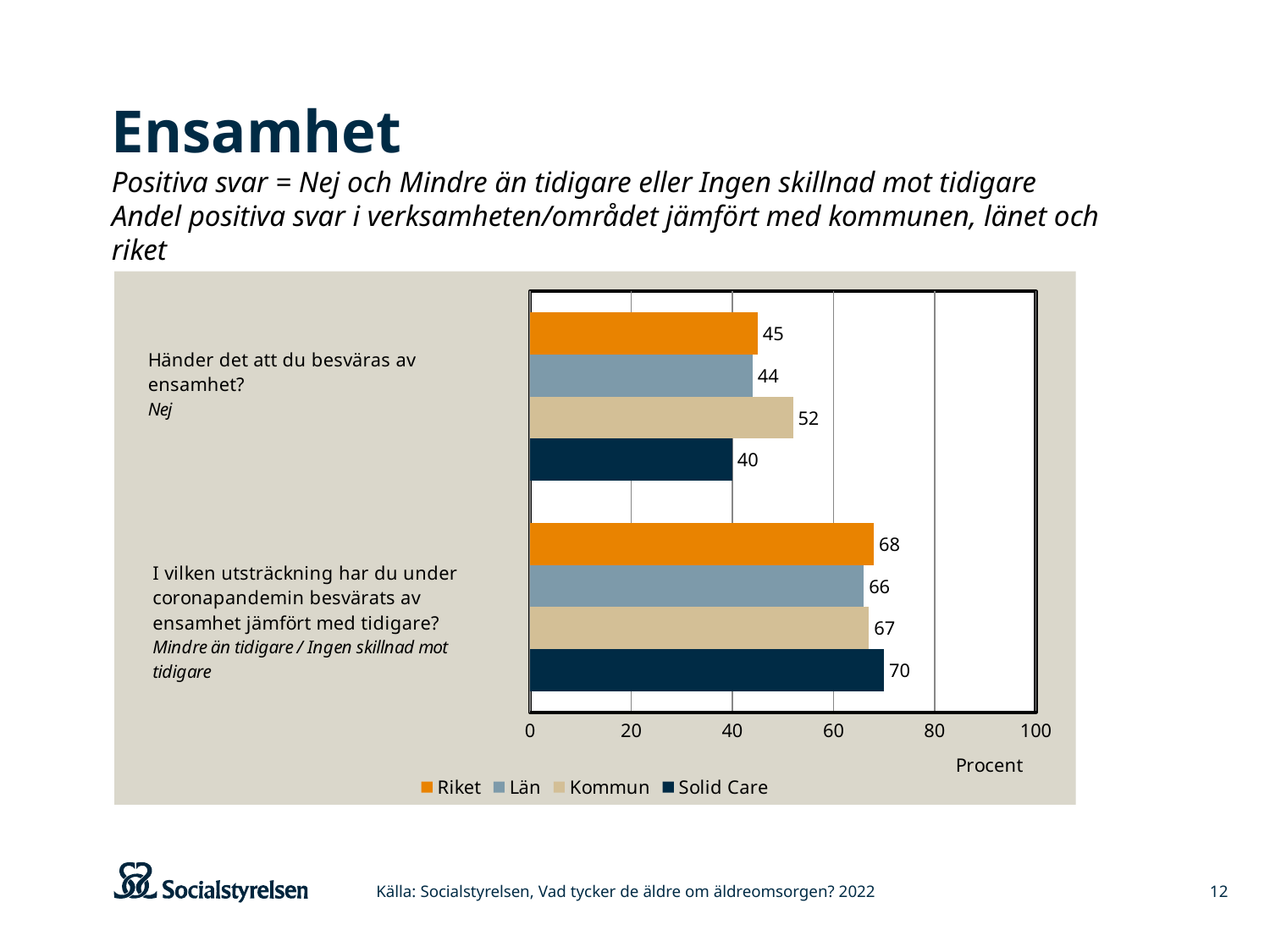
What is the value for Riket on the question 'I vilken utsträckning har du under coronapandemin besvärats av ensamhet jämfört med tidigare?' 68 Which series has the lowest value on the question 'Händer det att du besväras av ensamhet?' Solid Care What is the value for Kommun on the question 'Händer det att du besväras av ensamhet?' 52 What is the difference between the Kommun and Solid Care values on the question 'Händer det att du besväras av ensamhet?' 12 What kind of chart is shown on the slide? Bar chart What unit is shown on the x axis of the chart? Procent How many series does the legend list? 4 What is the value for Solid Care on the question 'Händer det att du besväras av ensamhet?' 40 Is the Solid Care value larger for 'Händer det att du besväras av ensamhet?' or for 'I vilken utsträckning har du under coronapandemin besvärats av ensamhet jämfört med tidigare?' I vilken utsträckning har du under coronapandemin besvärats av ensamhet jämfört med tidigare? Which series has the highest value on the question 'Händer det att du besväras av ensamhet?' Kommun What is the value for Län on the question 'I vilken utsträckning har du under coronapandemin besvärats av ensamhet jämfört med tidigare?' 66 Which series has the highest value on the question 'I vilken utsträckning har du under coronapandemin besvärats av ensamhet jämfört med tidigare?' Solid Care